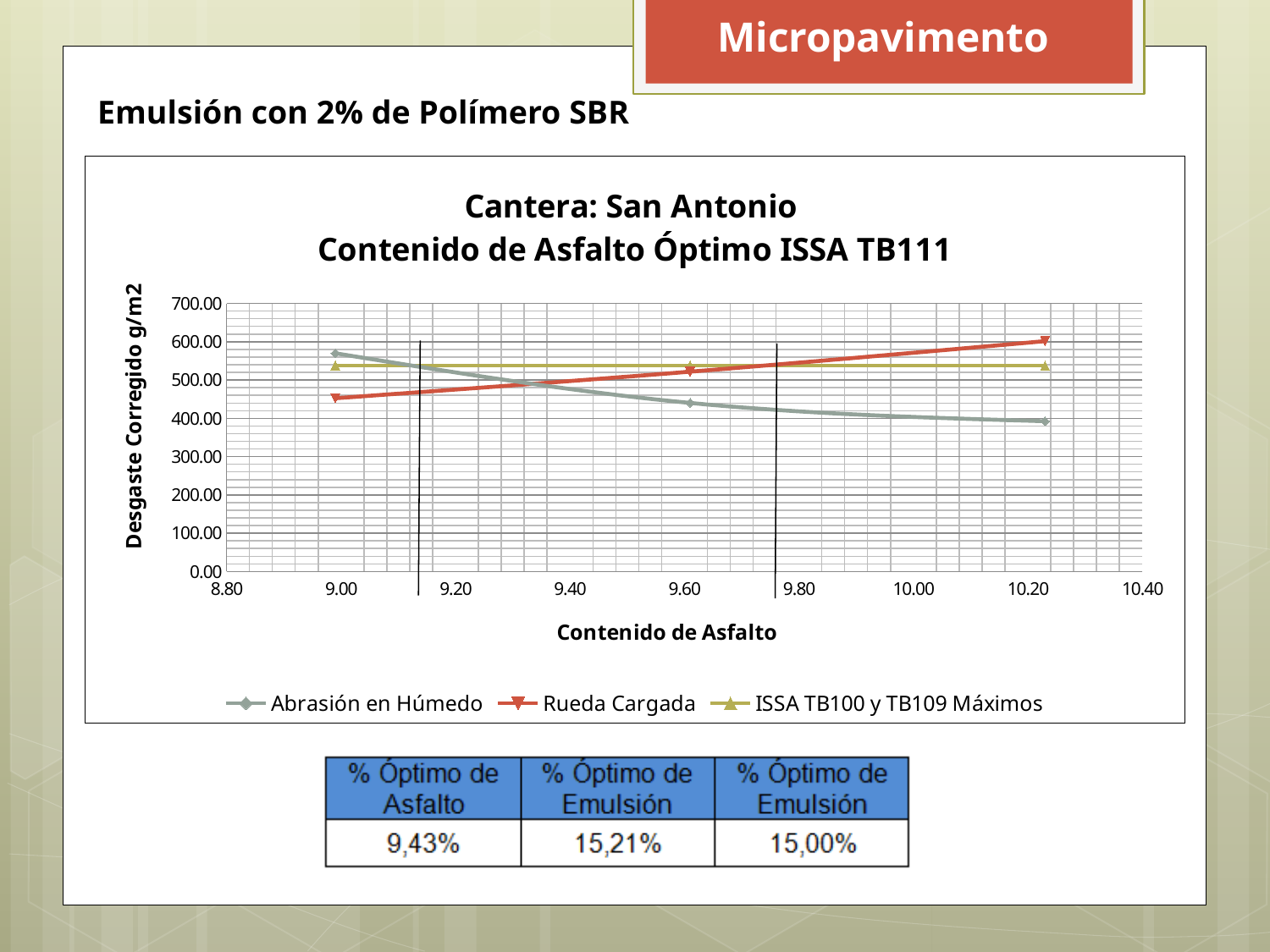
Is the Rueda Cargada value at Contenido de Asfalto 9.00 greater or less than 500.00? less Does the Rueda Cargada series rise or fall as Contenido de Asfalto increases? rise Is the ISSA TB100 y TB109 Máximos line greater or less than 500.00? greater How many series does the chart legend list? 3 Is the Abrasión en Húmedo value at Contenido de Asfalto 9.00 greater or less than 500.00? greater At Contenido de Asfalto 10.20, which series has the higher value: Abrasión en Húmedo or Rueda Cargada? Rueda Cargada How many data points are plotted for the Abrasión en Húmedo series? 3 What kind of chart is shown on the slide? line chart Does the Abrasión en Húmedo series rise or fall as Contenido de Asfalto increases? fall At Contenido de Asfalto 9.00, which series has the higher value: Abrasión en Húmedo or Rueda Cargada? Abrasión en Húmedo What is the label of the vertical axis of the chart? Desgaste Corregido g/m2